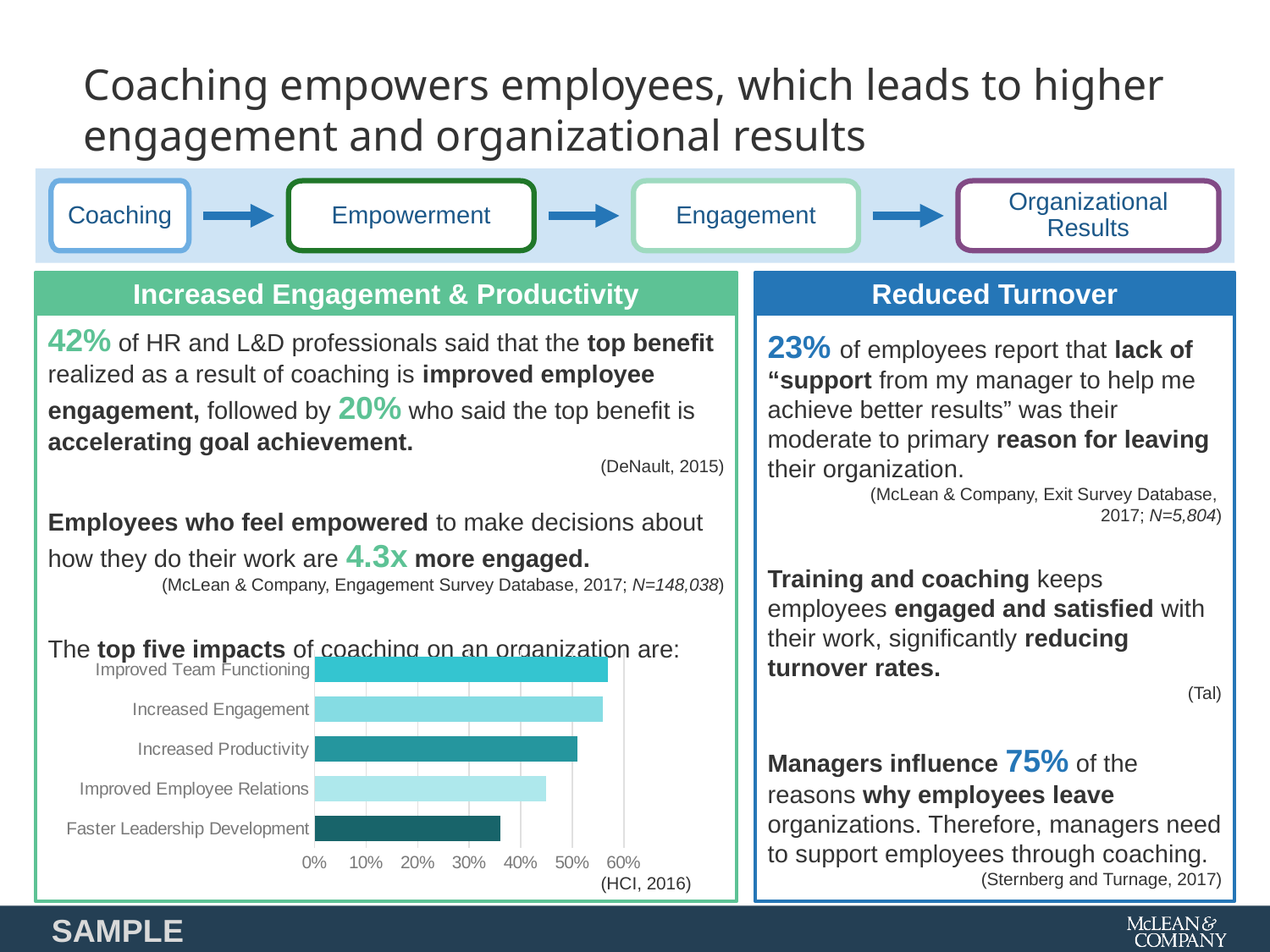
Which is larger in the bar chart, Increased Productivity or Improved Employee Relations? Increased Productivity Is the value for Improved Employee Relations greater or less than 50%? less Which is larger in the bar chart, Improved Employee Relations or Faster Leadership Development? Improved Employee Relations What kind of chart is used to show the top five impacts of coaching on an organization? bar chart Is the value for Increased Productivity greater or less than 40%? greater Is the value for Improved Employee Relations greater or less than 40%? greater What is the highest value shown on the x axis of the bar chart? 60% How many impacts of coaching are plotted in the bar chart? 5 What source is cited below the bar chart? HCI, 2016 Which impact of coaching has the lowest value in the bar chart? Faster Leadership Development